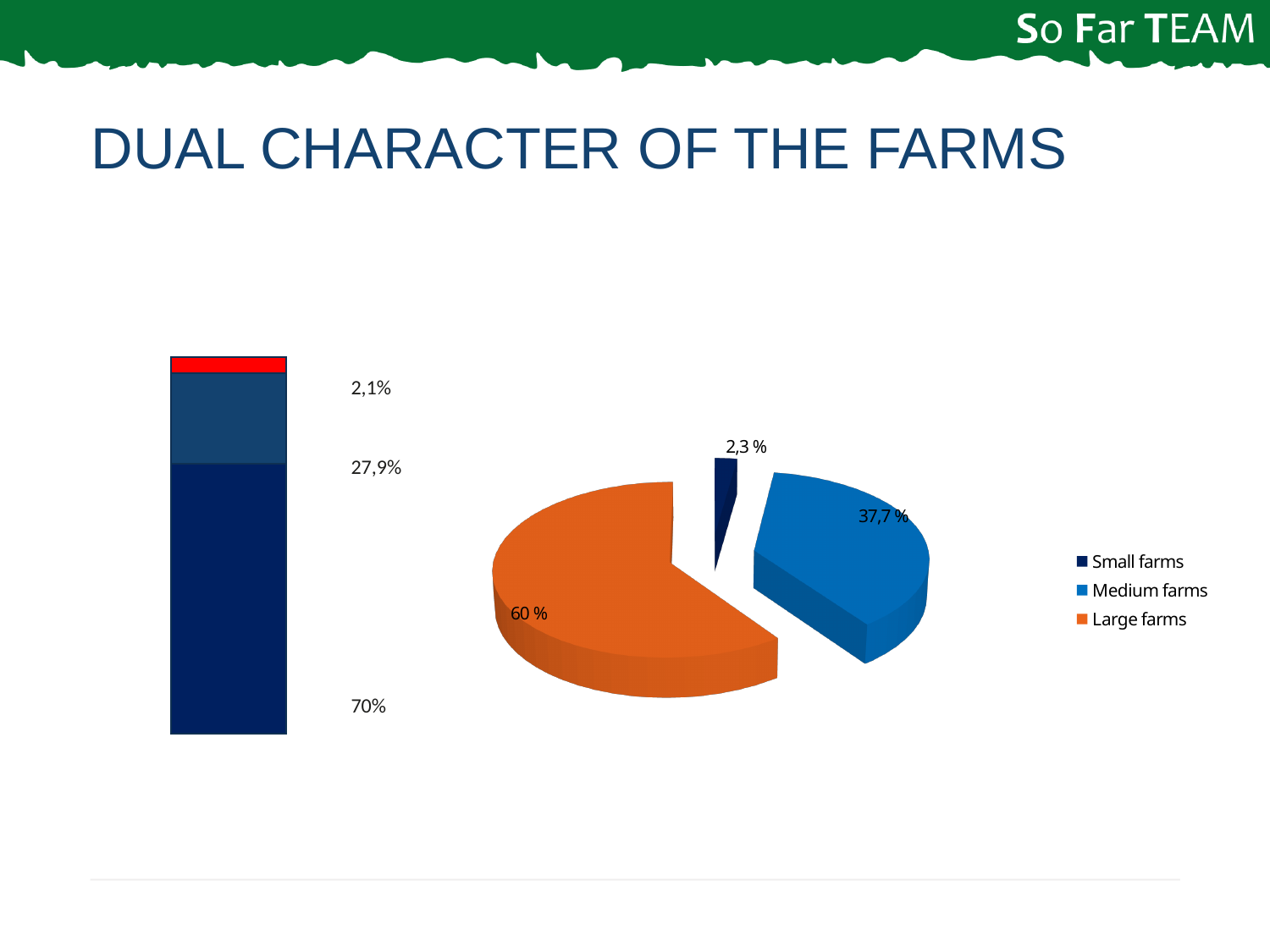
In the pie chart, what is the difference between the shares of Large farms and Medium farms? 22,3 % In the pie chart, which category has the smallest slice? Small farms In the pie chart, what share is shown for Large farms? 60 % What kind of chart is the chart on the right of the slide? Pie chart In the pie chart, what share is shown for Medium farms? 37,7 % What kind of chart is the chart on the left of the slide? Bar chart How many slices does the pie chart have? 3 In the stacked bar chart on the left, what is the total of the three labelled segments (2,1%, 27,9% and 70%)? 100% In the pie chart, what share is shown for Small farms? 2,3 % In the pie chart, which is larger: the share of Medium farms or the share of Small farms? Medium farms How many entries does the legend of the pie chart list? 3 In the pie chart, which category has the largest slice? Large farms